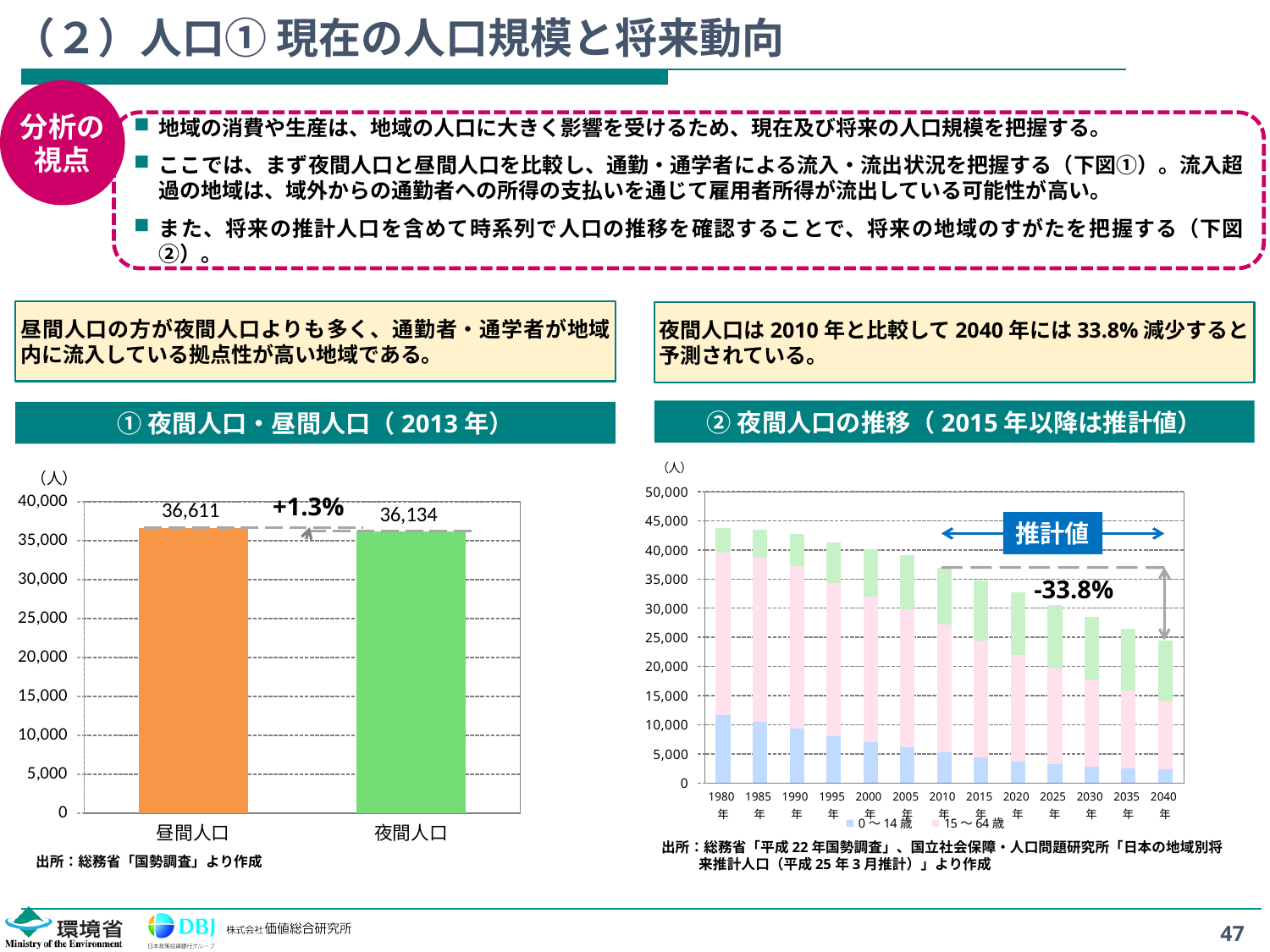
On the chart ② 夜間人口の推移, how many years are plotted on the x axis? 13 On the chart ② 夜間人口の推移, what percentage change from 2010 to 2040 is annotated on the chart? -33.8% On the chart ① 夜間人口・昼間人口（2013年）, what is the value for 夜間人口? 36,134 On the chart ① 夜間人口・昼間人口（2013年）, what is the difference between 昼間人口 and 夜間人口? 477 On the chart ② 夜間人口の推移, is the total value for 2040 greater or less than 30,000? less On the chart ① 夜間人口・昼間人口（2013年）, which category has the higher value? 昼間人口 What kind of chart is ① 夜間人口・昼間人口（2013年）? Bar chart On the chart ① 夜間人口・昼間人口（2013年）, how many categories are plotted? 2 On the chart ① 夜間人口・昼間人口（2013年）, what percentage difference is annotated between the two bars? +1.3% On the chart ② 夜間人口の推移, is the total value for 1980 greater or less than 40,000? greater On the chart ② 夜間人口の推移, do the total values rise or fall from 1980 to 2040? Fall On the chart ① 夜間人口・昼間人口（2013年）, what is the value for 昼間人口? 36,611